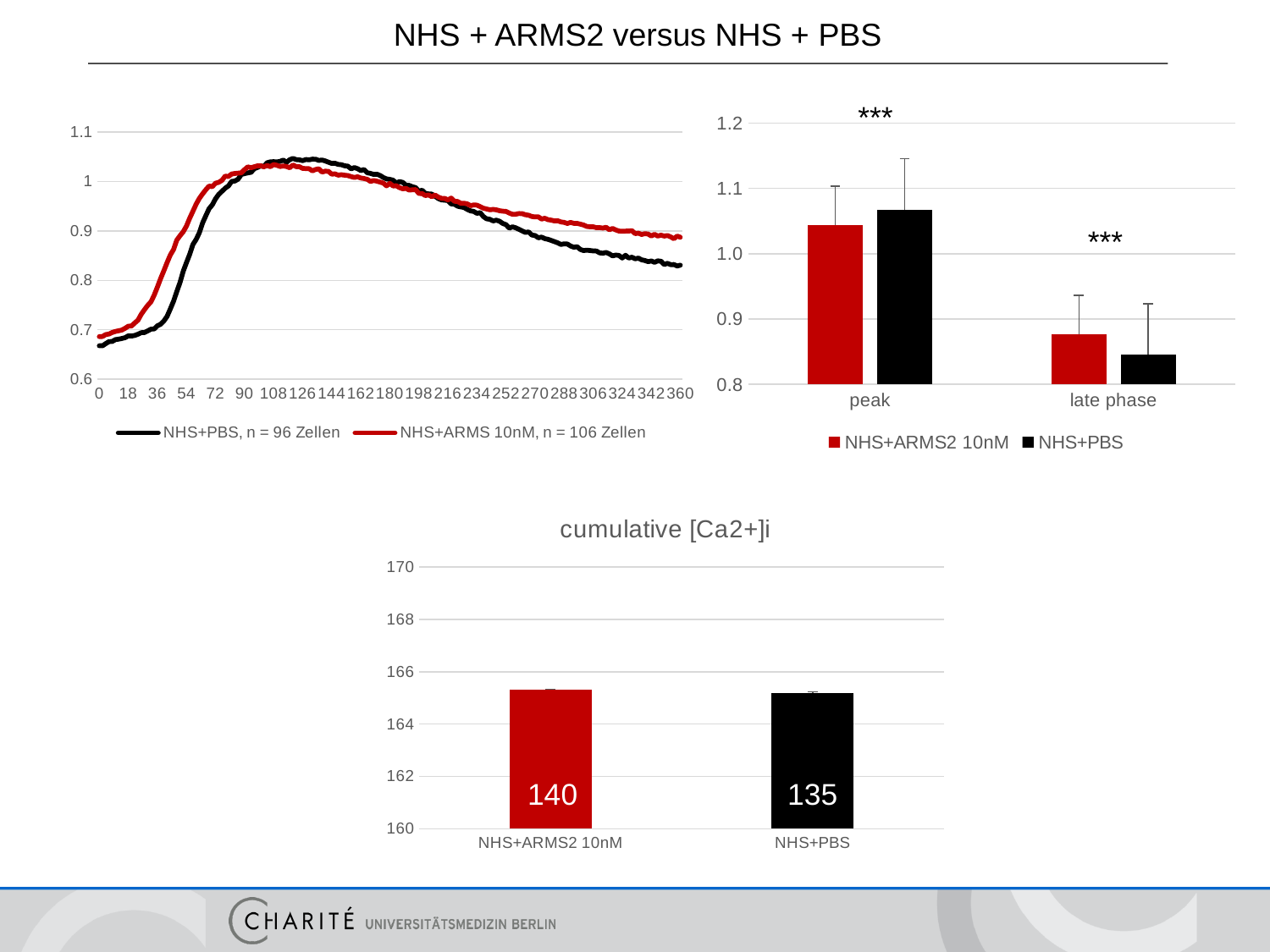
What kind of chart is the top-left chart? line chart In the top-left line chart, do the values rise or fall between x = 180 and x = 360? fall In the top-left line chart, which series is higher at x = 360? NHS+ARMS 10nM, n = 106 Zellen How many categories are shown on the x axis of the top-right bar chart? 2 In the top-right bar chart, is the value for NHS+ARMS2 10nM at late phase greater or less than 0.9? less In the top-right bar chart, which category has the higher value for NHS+PBS, peak or late phase? peak In the bottom chart 'cumulative [Ca2+]i', what number is printed inside the NHS+PBS bar? 135 In the top-right bar chart, is the value for NHS+PBS at peak greater or less than 1.0? greater What is the title of the bottom chart? cumulative [Ca2+]i In the top-left line chart, is the value of NHS+PBS at x = 0 greater or less than 0.7? less How many series does the legend of the top-left line chart list? 2